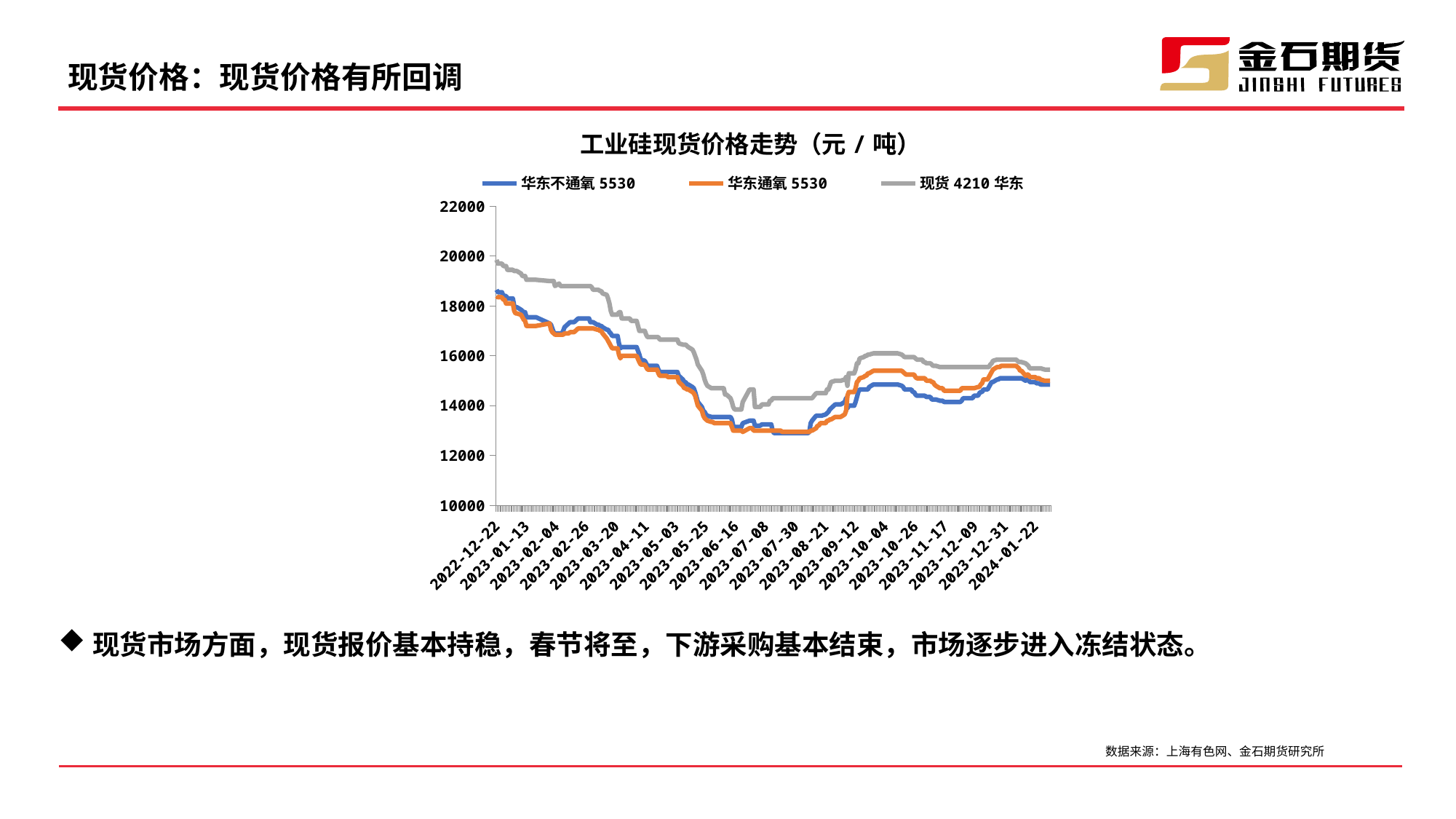
Is the value for 现货 4210 华东 at 2022-12-22 greater or less than 18000? greater Is the value for 华东通氧 5530 at 2023-07-30 greater or less than 14000? less Is the value for 华东不通氧 5530 at 2023-07-08 greater or less than 14000? less What is the highest value shown on the y axis? 22000 What kind of chart is shown on the slide? line chart How many series does the legend list? 3 Which series has the highest values across the chart? 现货 4210 华东 What is the title of the chart? 工业硅现货价格走势（元／吨） Which series is drawn in gray? 现货 4210 华东 Overall, do the prices rise or fall from 2022-12-22 to 2024-01-22? fall Around 2023-11-17, which series is lower: 华东不通氧 5530 or 华东通氧 5530? 华东不通氧 5530